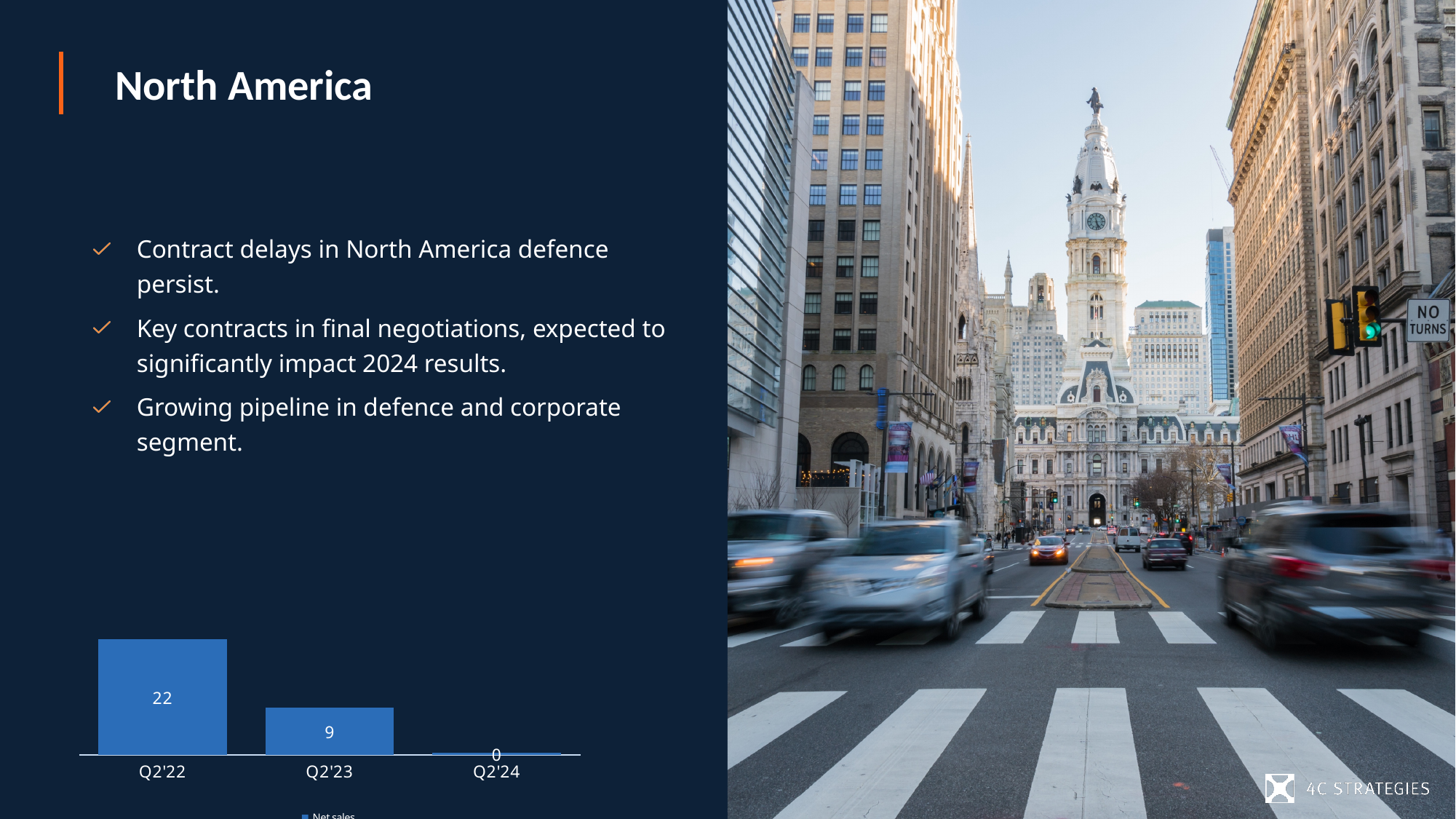
Do the values rise or fall from Q2'22 to Q2'24? Fall What is the value for Q2'23 in the bar chart? 9 What is the value for Q2'24 in the bar chart? 0 Which quarter has the highest value in the bar chart? Q2'22 How many quarters are shown in the bar chart? 3 Which quarter has the lowest value in the bar chart? Q2'24 What kind of chart is shown on the slide? Bar chart Which is larger, the value for Q2'22 or the value for Q2'23? Q2'22 What is the value for Q2'22 in the bar chart? 22 What is the difference between the values for Q2'23 and Q2'24? 9 What series name does the chart legend show? Net sales What is the difference between the values for Q2'22 and Q2'23? 13